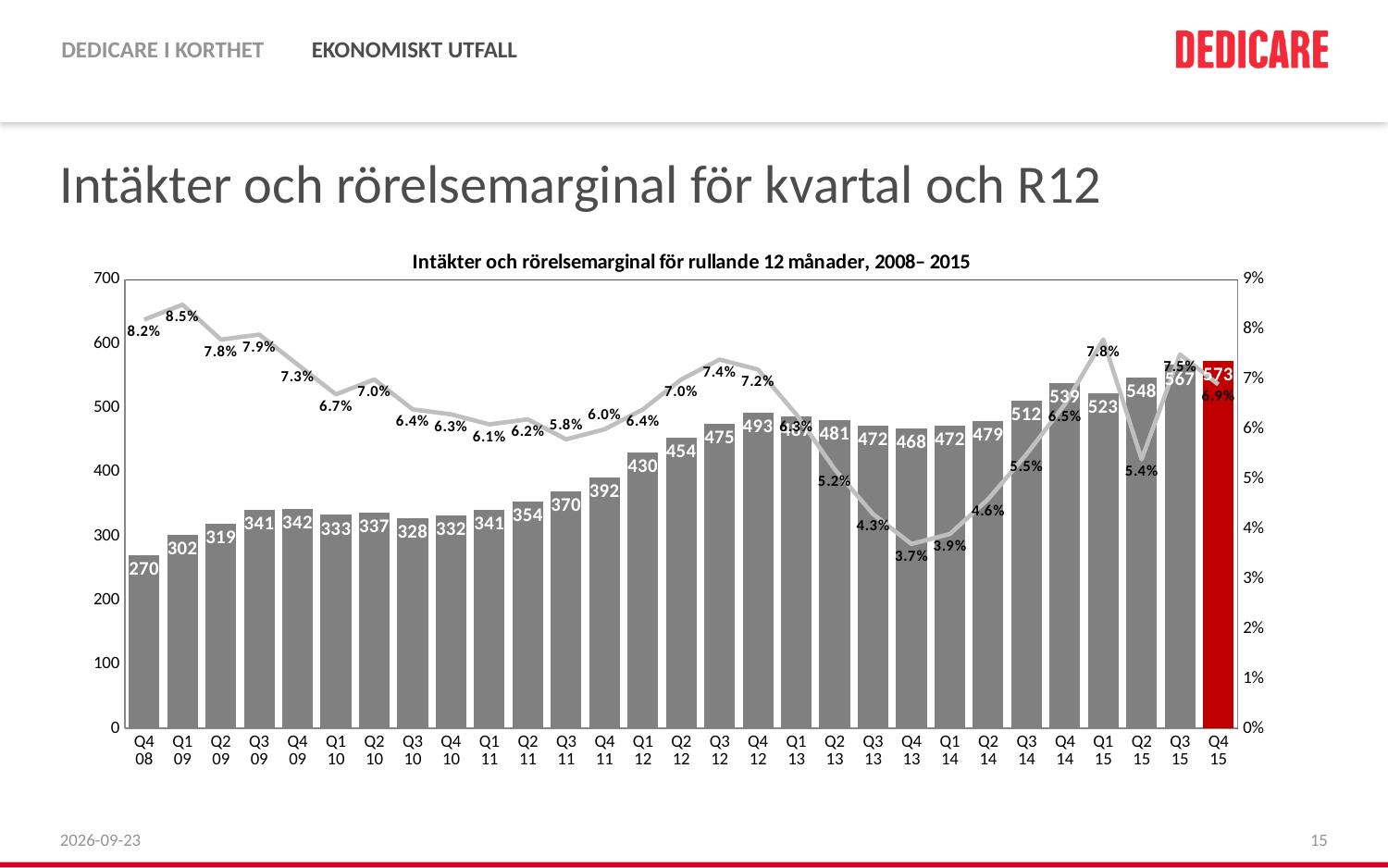
What operating margin is shown for Q1 09? 8.5% What is the revenue value shown for Q4 08? 270 Which quarter has the lowest operating margin on the line? Q4 13 What operating margin is shown for Q4 13? 3.7% Which quarter has the lowest revenue bar? Q4 08 Which quarter has the highest revenue bar? Q4 15 How many quarters are shown on the x axis? 29 What is the difference between the revenue for Q4 15 and Q4 08? 303 What kind of chart is this? Combined bar and line chart Which is larger, the revenue for Q4 12 or Q2 14? Q4 12 Which bar is coloured red instead of grey? Q4 15 What is the revenue value shown for Q4 15? 573